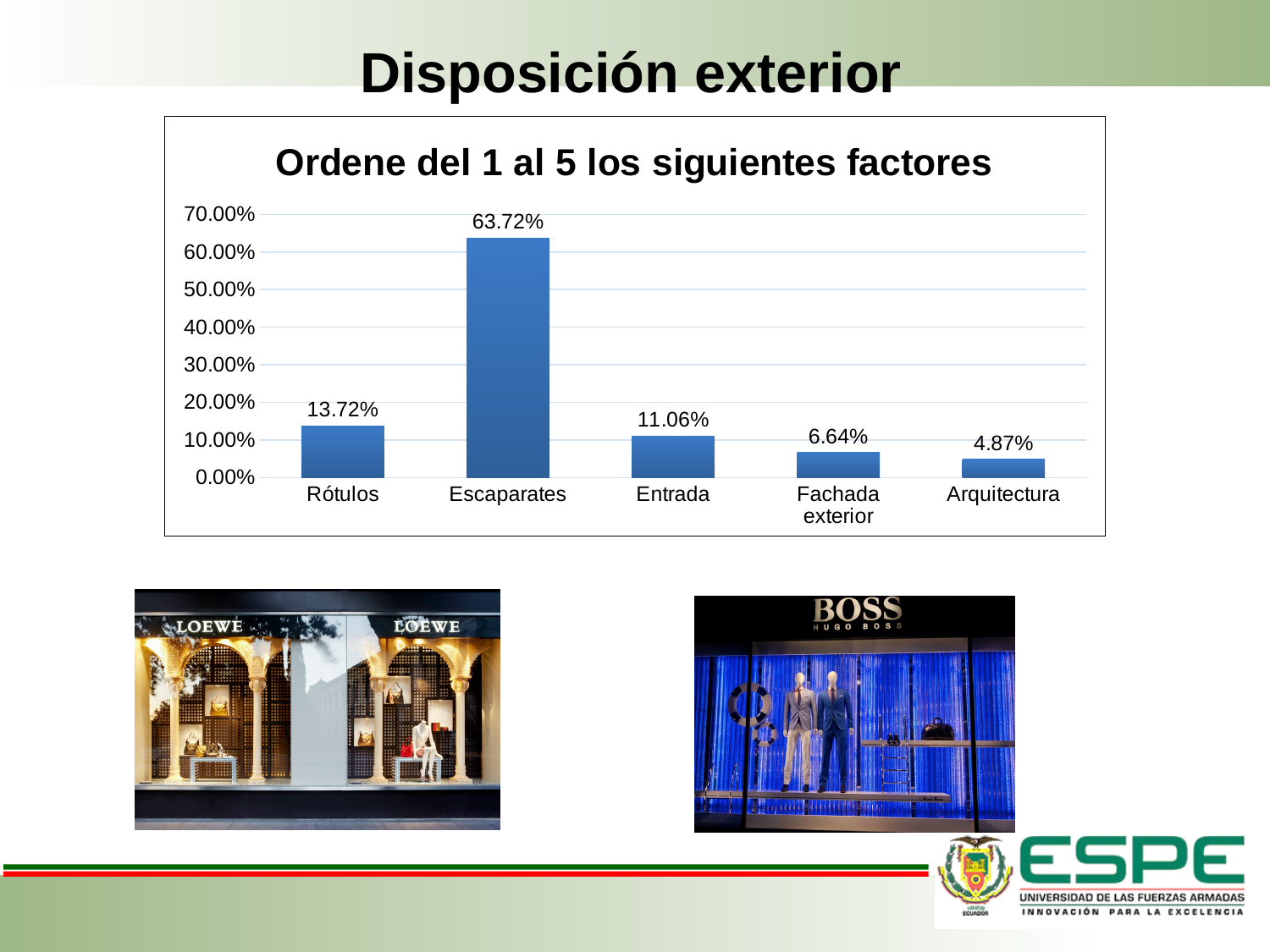
What is the value for Arquitectura? 4.87% What is the difference between the values for Escaparates and Rótulos? 50.00% What is the title of the chart? Ordene del 1 al 5 los siguientes factores What is the value for Escaparates? 63.72% Which category has the highest value? Escaparates Which is larger, the value for Entrada or the value for Fachada exterior? Entrada What is the value for Fachada exterior? 6.64% What is the value for Rótulos? 13.72% Is the value for Escaparates greater or less than 60.00%? greater Which category has the lowest value? Arquitectura How many categories are shown on the x axis? 5 What kind of chart is shown on the slide? Bar chart